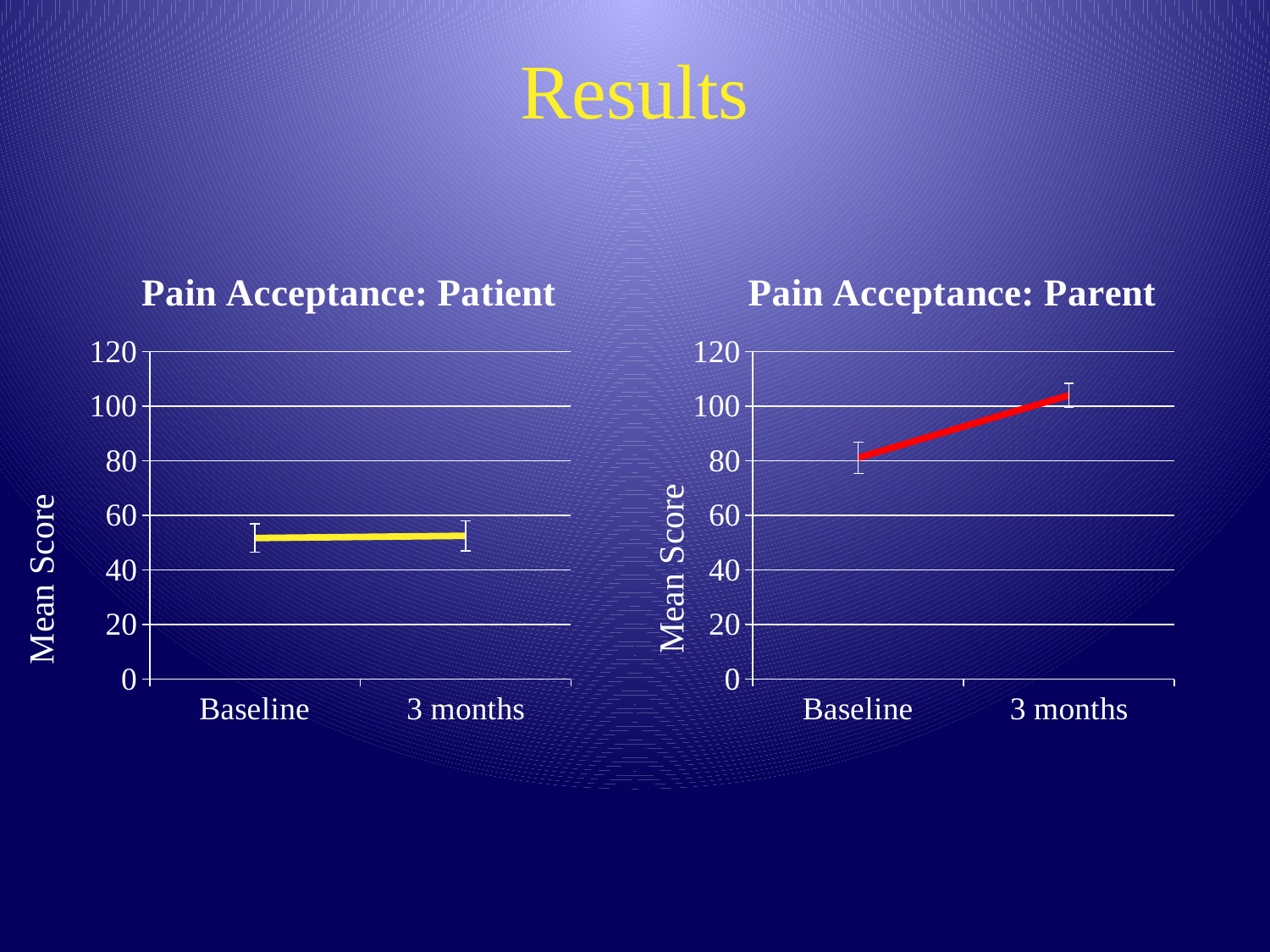
In the 'Pain Acceptance: Parent' chart, do the values rise or fall from Baseline to 3 months? rise In the 'Pain Acceptance: Patient' chart, is the value at Baseline greater or less than 60? less In the 'Pain Acceptance: Parent' chart, which is larger, the value at Baseline or at 3 months? 3 months In the 'Pain Acceptance: Parent' chart, is the value at Baseline greater or less than 100? less What colour is the line in the 'Pain Acceptance: Parent' chart? red In the 'Pain Acceptance: Parent' chart, is the value at 3 months greater or less than 100? greater Which chart on the slide shows the larger increase from Baseline to 3 months, the Patient chart or the Parent chart? Pain Acceptance: Parent What is the y-axis label on the 'Pain Acceptance: Patient' chart? Mean Score In the 'Pain Acceptance: Parent' chart, which time point has the lowest value? Baseline In the 'Pain Acceptance: Parent' chart, how many time points are plotted on the x axis? 2 In the 'Pain Acceptance: Patient' chart, what kind of chart is shown? line chart